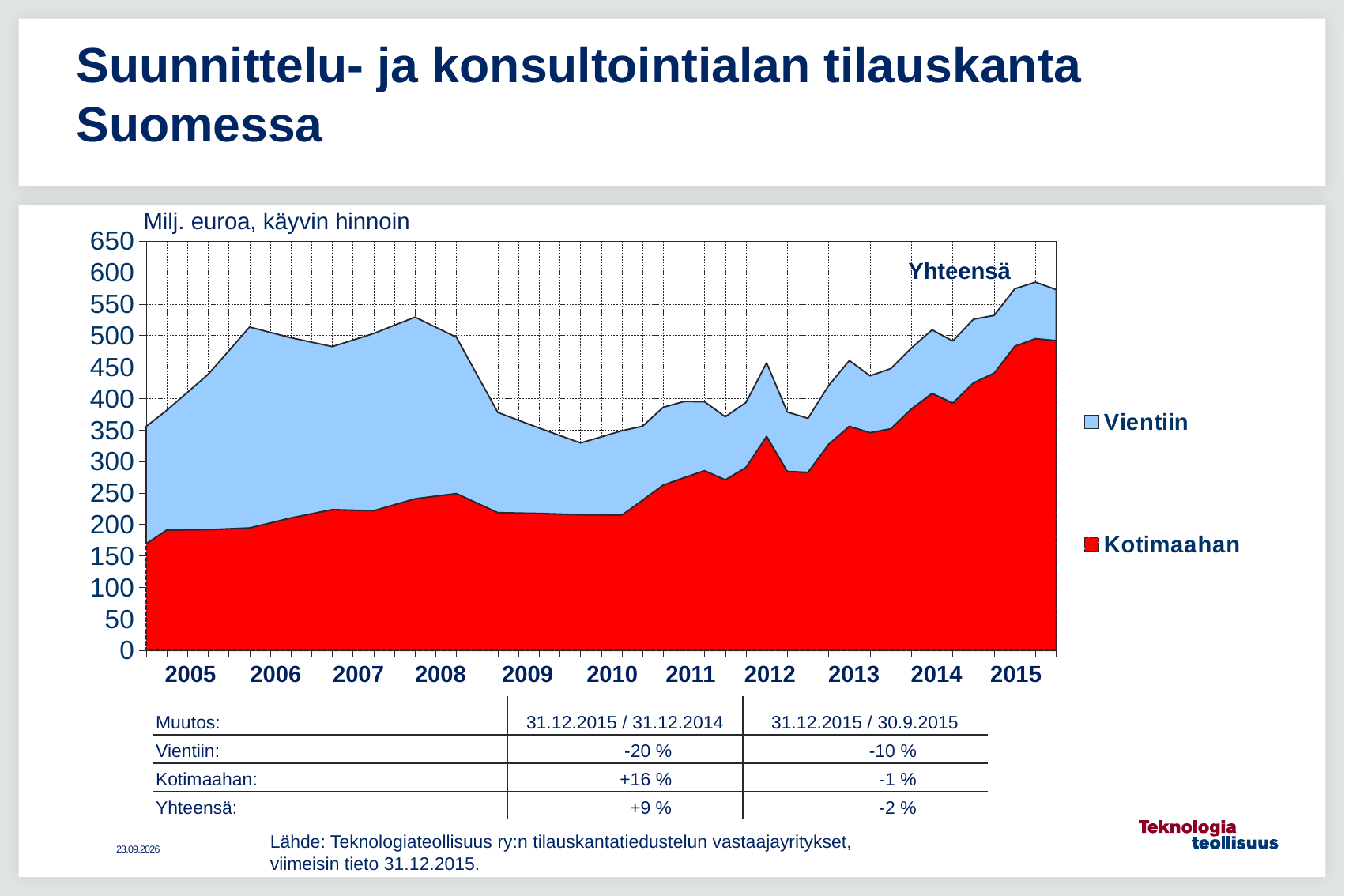
Is the Kotimaahan value at the end of 2015 greater or less than 450? greater Is the Kotimaahan value at the start of 2005 greater or less than 200? less What unit is stated above the chart's y axis? Milj. euroa, käyvin hinnoin How many years are labelled on the chart's x axis? 11 Does the Kotimaahan series rise or fall between 2012 and 2015? rise Is the total (Yhteensä) value at its low point in 2010 greater or less than 350? less At the end of 2015, which series is larger, Vientiin or Kotimaahan? Kotimaahan How many series does the chart legend list? 2 What is the highest value shown on the chart's y axis? 650 What kind of chart is shown on the slide? Stacked area chart What are the two series named in the chart legend? Vientiin and Kotimaahan